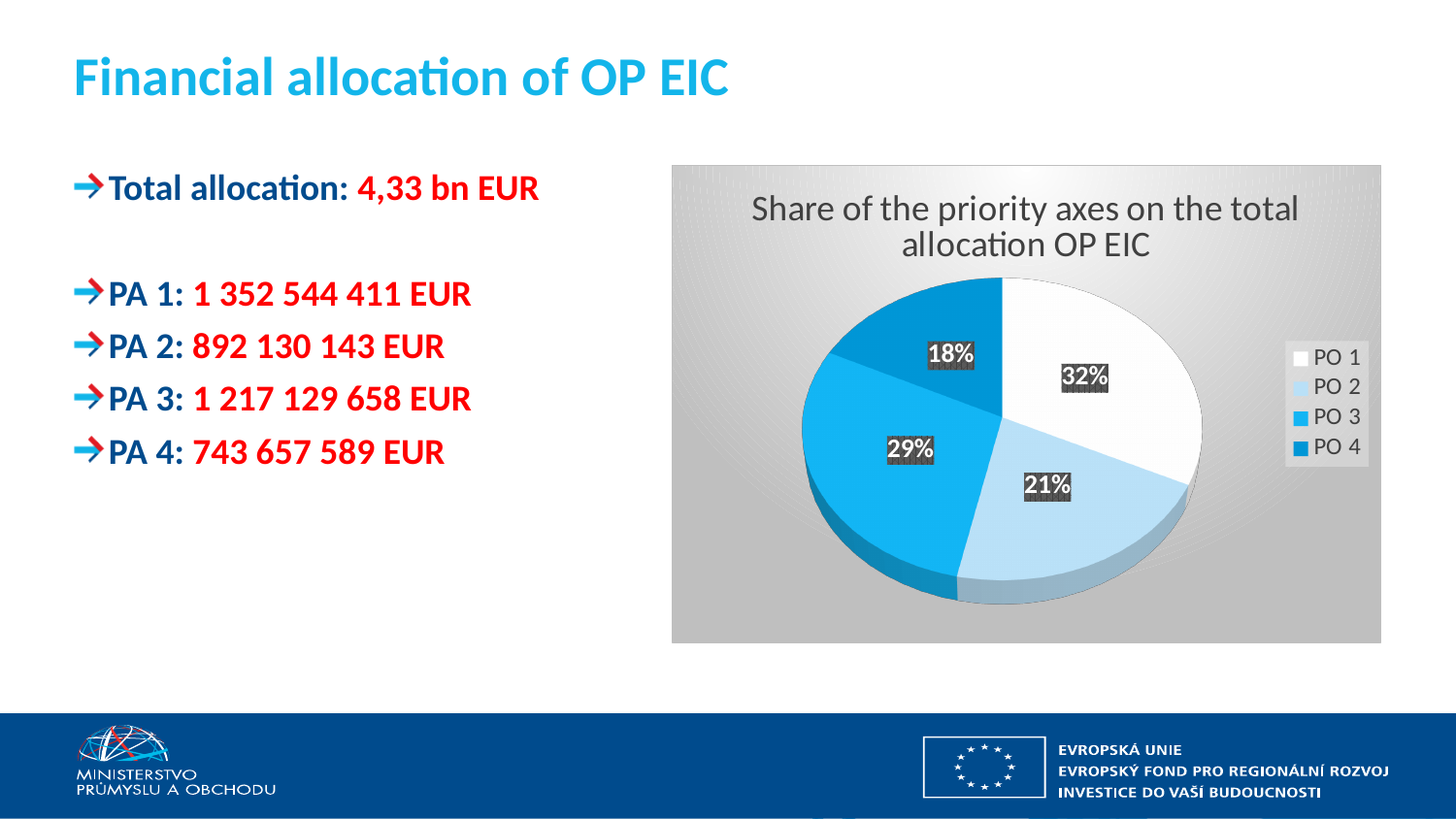
What share of the pie does PO 1 have? 32% What type of chart is shown on the slide? pie chart Which has a larger share, PO 2 or PO 3? PO 3 How many entries does the chart legend list? 4 Which priority axis has the largest share of the pie? PO 1 How many slices does the pie chart have? 4 What share of the pie does PO 4 have? 18% What share of the pie does PO 2 have? 21% What is the title of the chart? Share of the priority axes on the total allocation OP EIC What share of the pie does PO 3 have? 29% Which priority axis has the smallest share of the pie? PO 4 What is the difference in percentage points between the shares of PO 1 and PO 4? 14